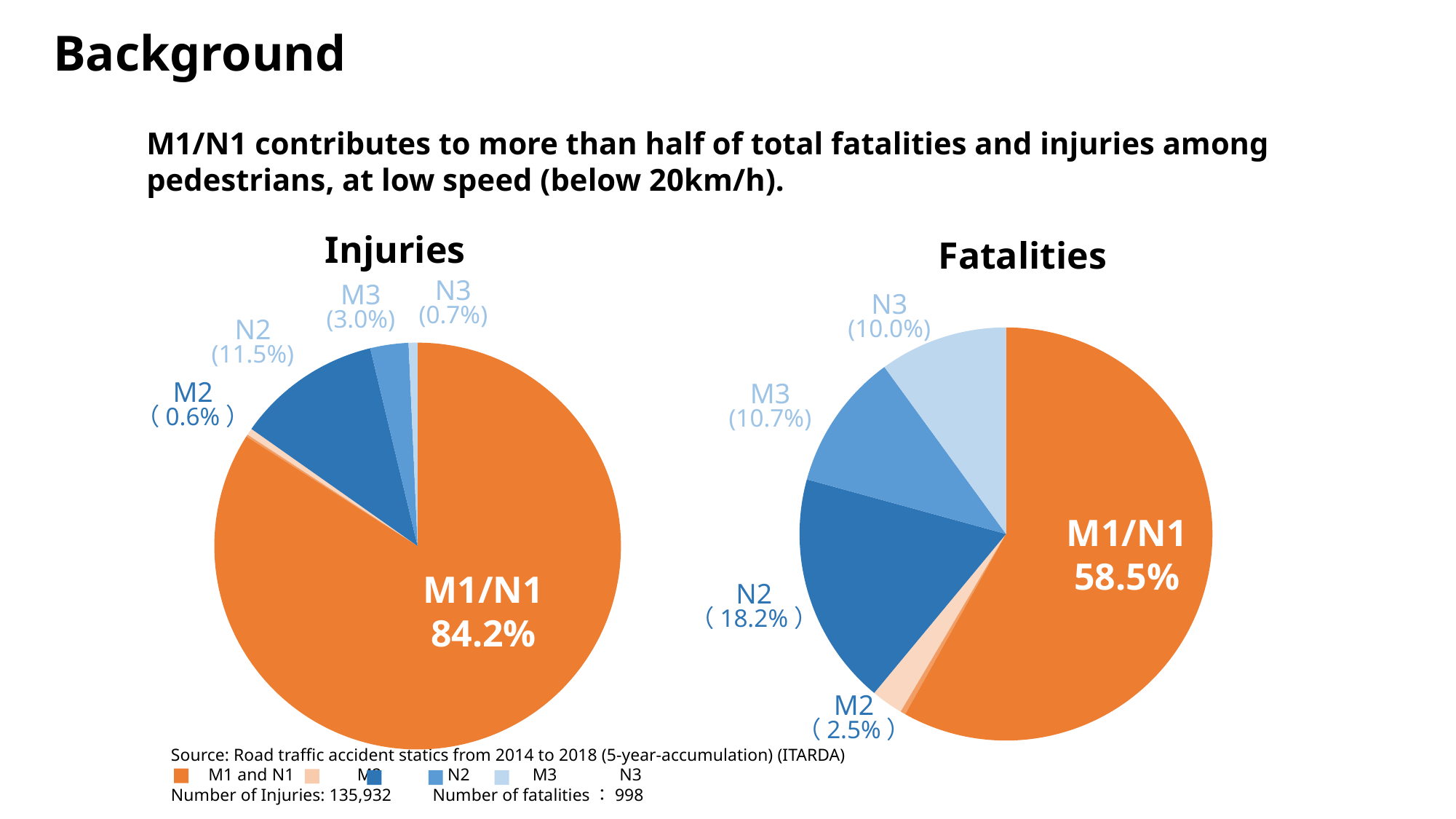
In the Injuries pie chart, which category has the smallest share? M2 In the Fatalities pie chart, which category has the largest share? M1/N1 What is the difference between the M1/N1 share in the Injuries chart and the M1/N1 share in the Fatalities chart? 25.7% In the Fatalities pie chart, which is larger, the share for M3 or the share for N3? M3 In the Fatalities pie chart, what is the difference between the N2 share and the M2 share? 15.7% In the Fatalities pie chart, what share does N2 account for? 18.2% What is the title of the chart on the left? Injuries What type of chart is used for Fatalities? Pie chart In the Injuries pie chart, what share does M1/N1 account for? 84.2% In the Injuries pie chart, what is the value for N2? 11.5% In the Fatalities pie chart, what is the value for M3? 10.7% How many slices does the Injuries pie chart have? 5